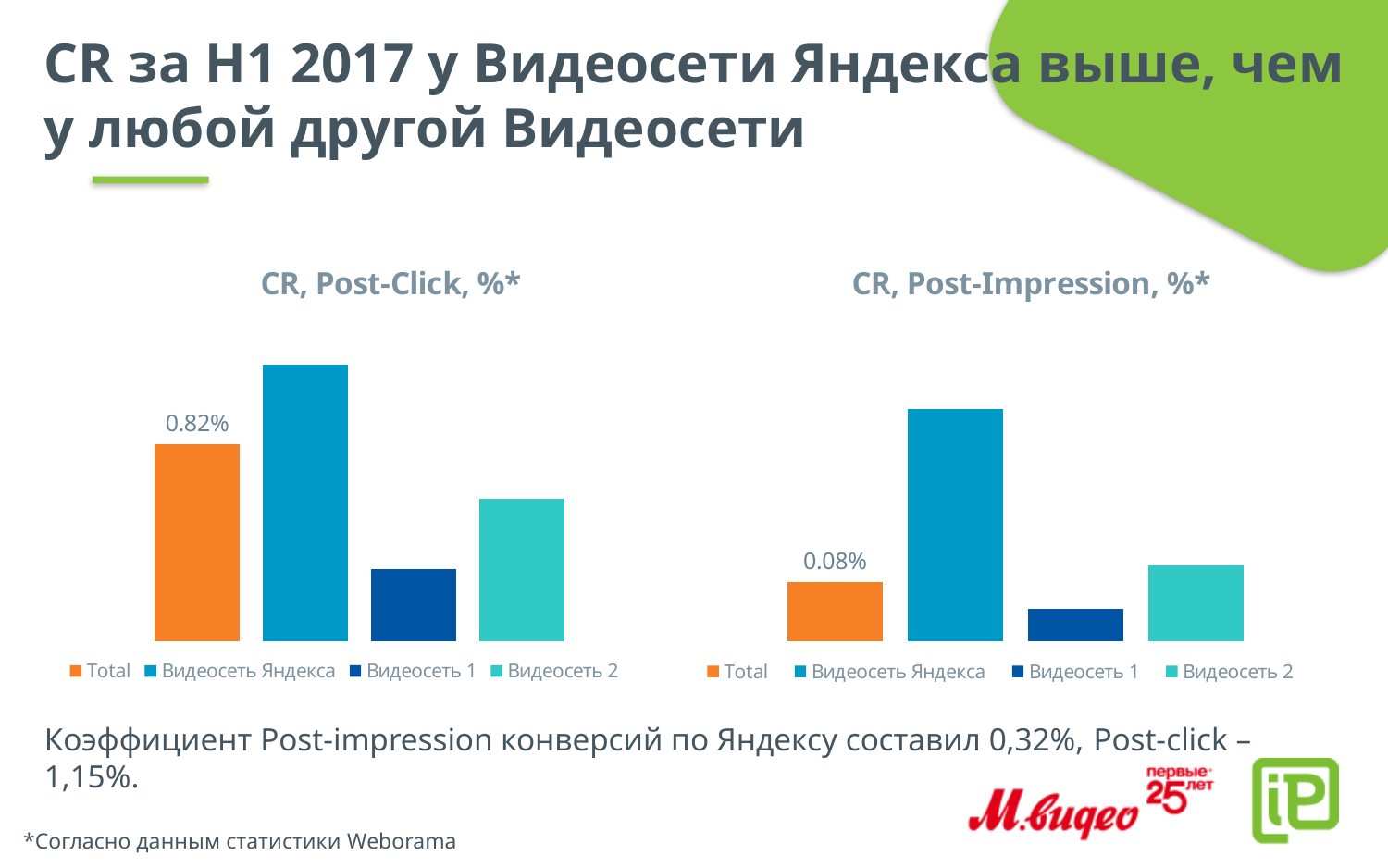
In the 'CR, Post-Click, %*' chart, which category has the highest bar? Видеосеть Яндекса How many bars are shown in the 'CR, Post-Click, %*' chart? 4 What type of chart is the 'CR, Post-Impression, %*' chart? Bar chart In the 'CR, Post-Impression, %*' chart, which category has the lowest bar? Видеосеть 1 In the 'CR, Post-Click, %*' chart, what is the value for Total? 0.82% In the 'CR, Post-Impression, %*' chart, which category has the highest bar? Видеосеть Яндекса In the 'CR, Post-Impression, %*' chart, what is the value for Total? 0.08% How many entries does the legend of the 'CR, Post-Impression, %*' chart list? 4 In the 'CR, Post-Click, %*' chart, which category has the lowest bar? Видеосеть 1 In the 'CR, Post-Impression, %*' chart, which is larger: Видеосеть Яндекса or Видеосеть 2? Видеосеть Яндекса What is the title of the left chart on the slide? CR, Post-Click, %* In the 'CR, Post-Click, %*' chart, which is larger: Total or Видеосеть 2? Total